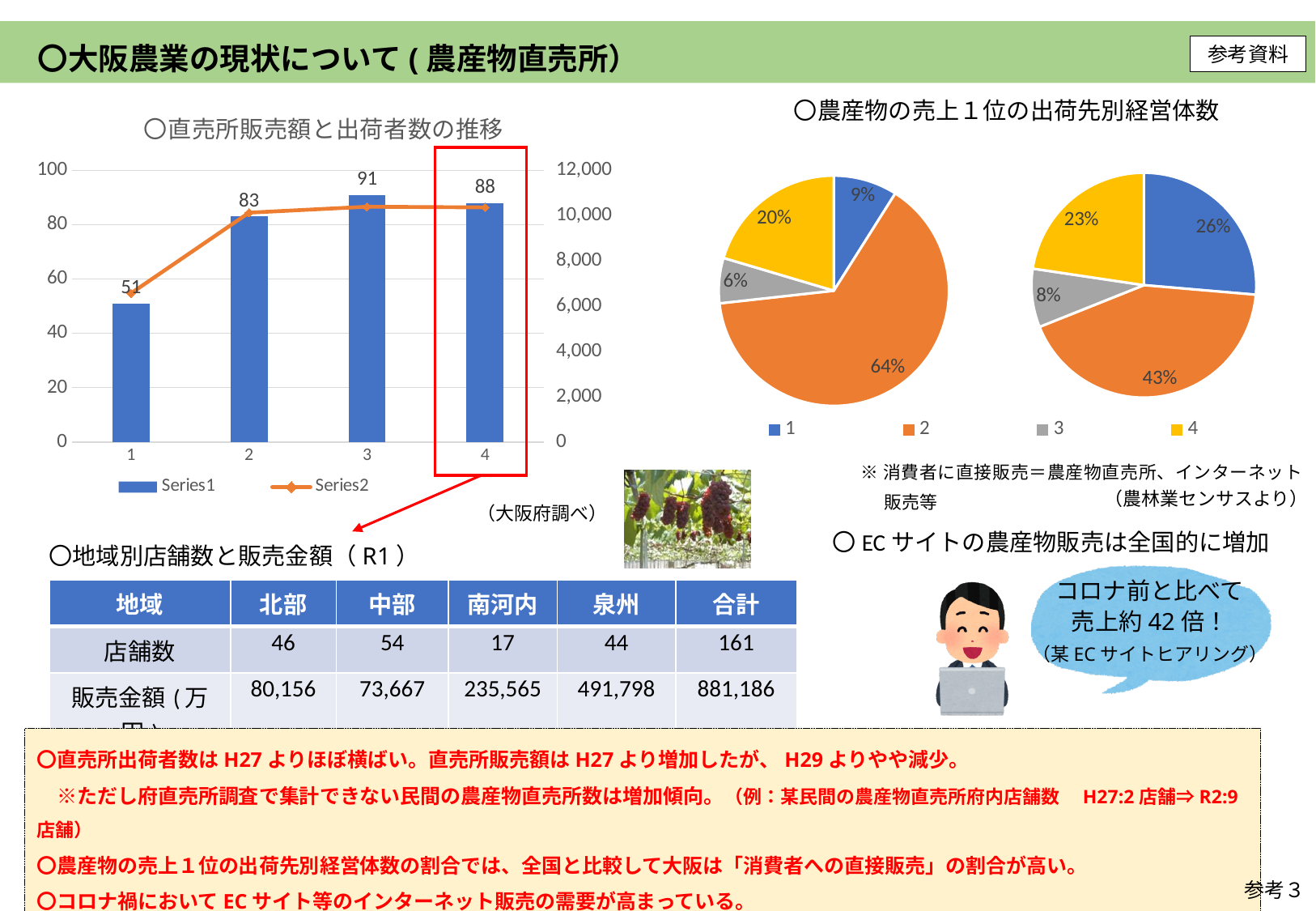
In the chart titled 直売所販売額と出荷者数の推移, is the Series2 value for category 1 greater or less than 8,000? less In the chart titled 直売所販売額と出荷者数の推移, what is the Series1 value for category 1? 51 In the left pie chart under 農産物の売上1位の出荷先別経営体数, what share does slice 2 have? 64% In the chart titled 直売所販売額と出荷者数の推移, which category has the highest Series1 value? 3 In the right pie chart under 農産物の売上1位の出荷先別経営体数, which slice is the smallest? 3 In the chart titled 直売所販売額と出荷者数の推移, what is the Series1 value for category 3? 91 In the chart titled 直売所販売額と出荷者数の推移, which category has the lowest Series1 value? 1 In the right pie chart under 農産物の売上1位の出荷先別経営体数, what share does slice 1 have? 26% Which is larger: slice 4 in the left pie chart or slice 4 in the right pie chart? right pie chart (23%) In the chart titled 直売所販売額と出荷者数の推移, what is the difference between the Series1 values for category 2 and category 1? 32 In the chart titled 直売所販売額と出荷者数の推移, how many categories are shown on the x axis? 4 In the chart titled 直売所販売額と出荷者数の推移, how many series does the legend list? 2